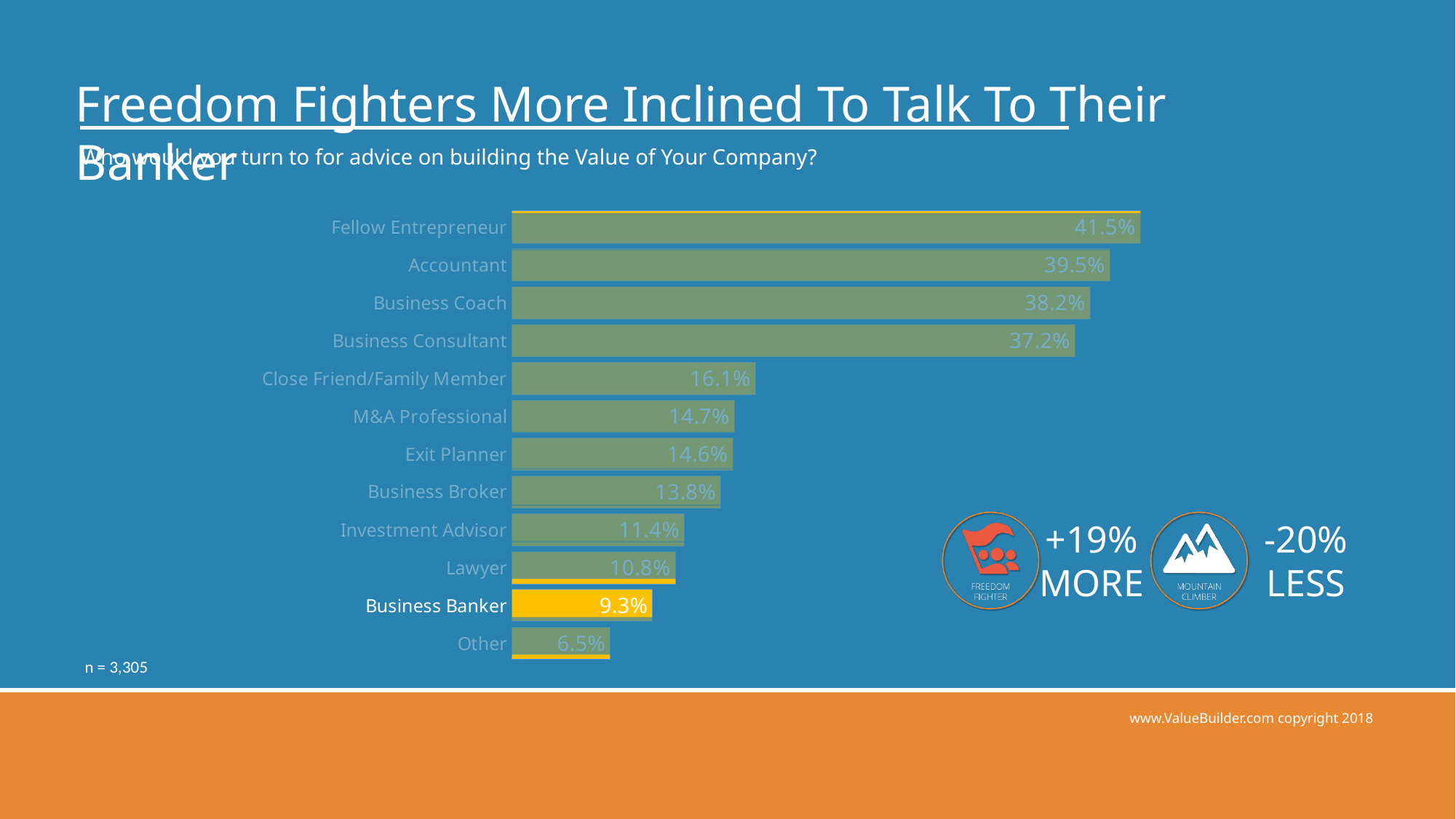
Which bar is highlighted in a different colour (yellow) from the others? Business Banker Which is larger, the value for Lawyer or the value for Investment Advisor? Investment Advisor What is the value shown for Business Banker? 9.3% What percentage of respondents would turn to a Fellow Entrepreneur for advice on building the value of their company? 41.5% What is the value shown for Close Friend/Family Member? 16.1% How many categories are shown in the bar chart? 12 Which is larger, the value for Business Consultant or the value for Close Friend/Family Member? Business Consultant What is the difference between the values for Business Banker and Other? 2.8% Which category has the highest value in the chart? Fellow Entrepreneur What kind of chart is shown on the slide? Bar chart Which category has the lowest value in the chart? Other What is the difference between the values for Accountant and Business Coach? 1.3%